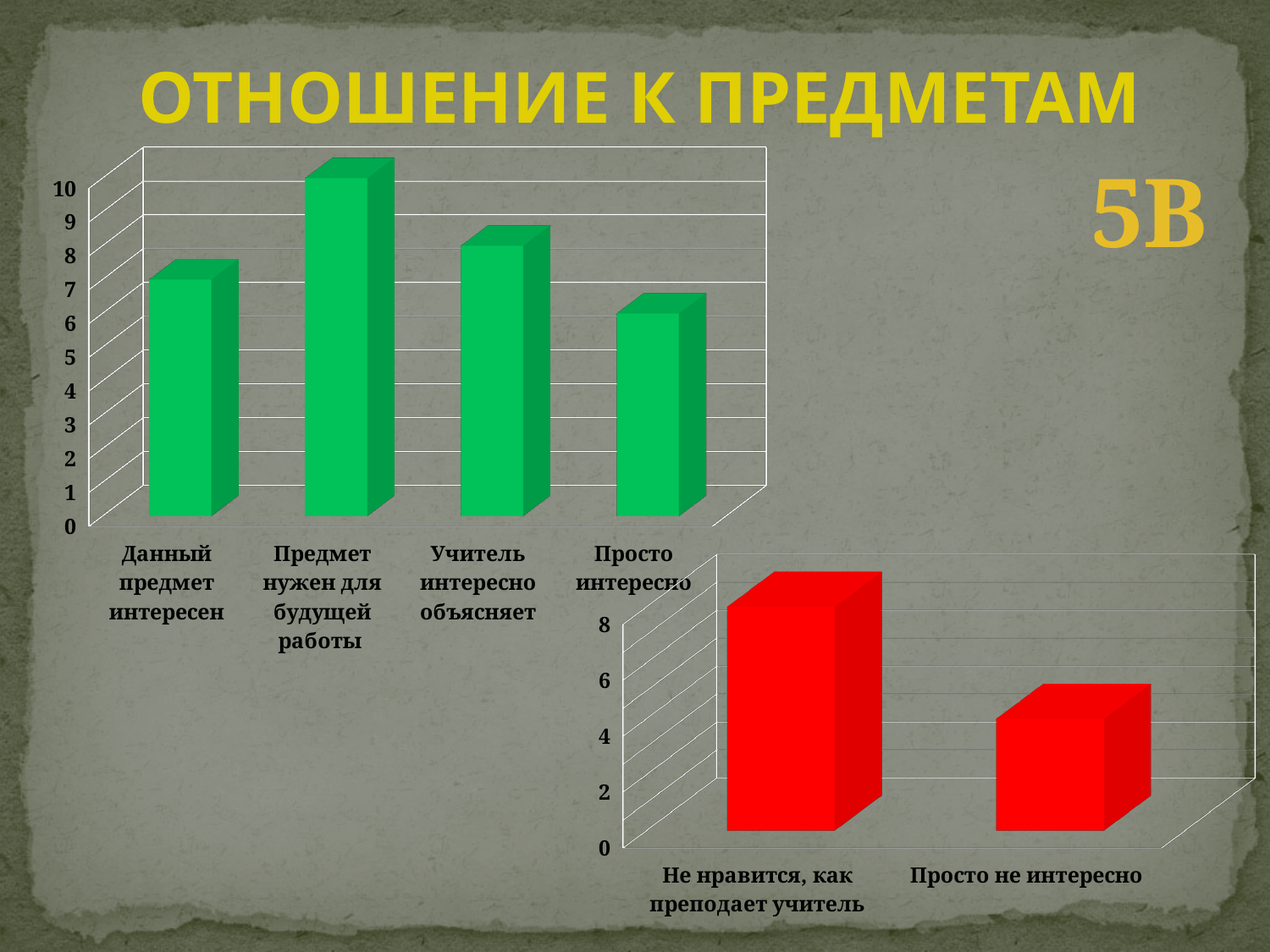
How many categories does the green chart on the left show? 4 In the green chart on the left, which category has the highest value? Предмет нужен для будущей работы In the green chart on the left, is the value for 'Данный предмет интересен' greater or less than 5? greater In the red chart at the bottom right, which category has the higher value? Не нравится, как преподает учитель In the green chart on the left, which is larger: 'Учитель интересно объясняет' or 'Просто интересно'? Учитель интересно объясняет What is the title of the slide? ОТНОШЕНИЕ К ПРЕДМЕТАМ In the red chart at the bottom right, is the value for 'Не нравится, как преподает учитель' greater or less than 6? greater In the green chart on the left, which category has the lowest value? Просто интересно How many categories does the red chart at the bottom right show? 2 In the green chart on the left, is the value for 'Просто интересно' greater or less than 8? less What kind of chart is the green chart on the left of the slide? bar chart